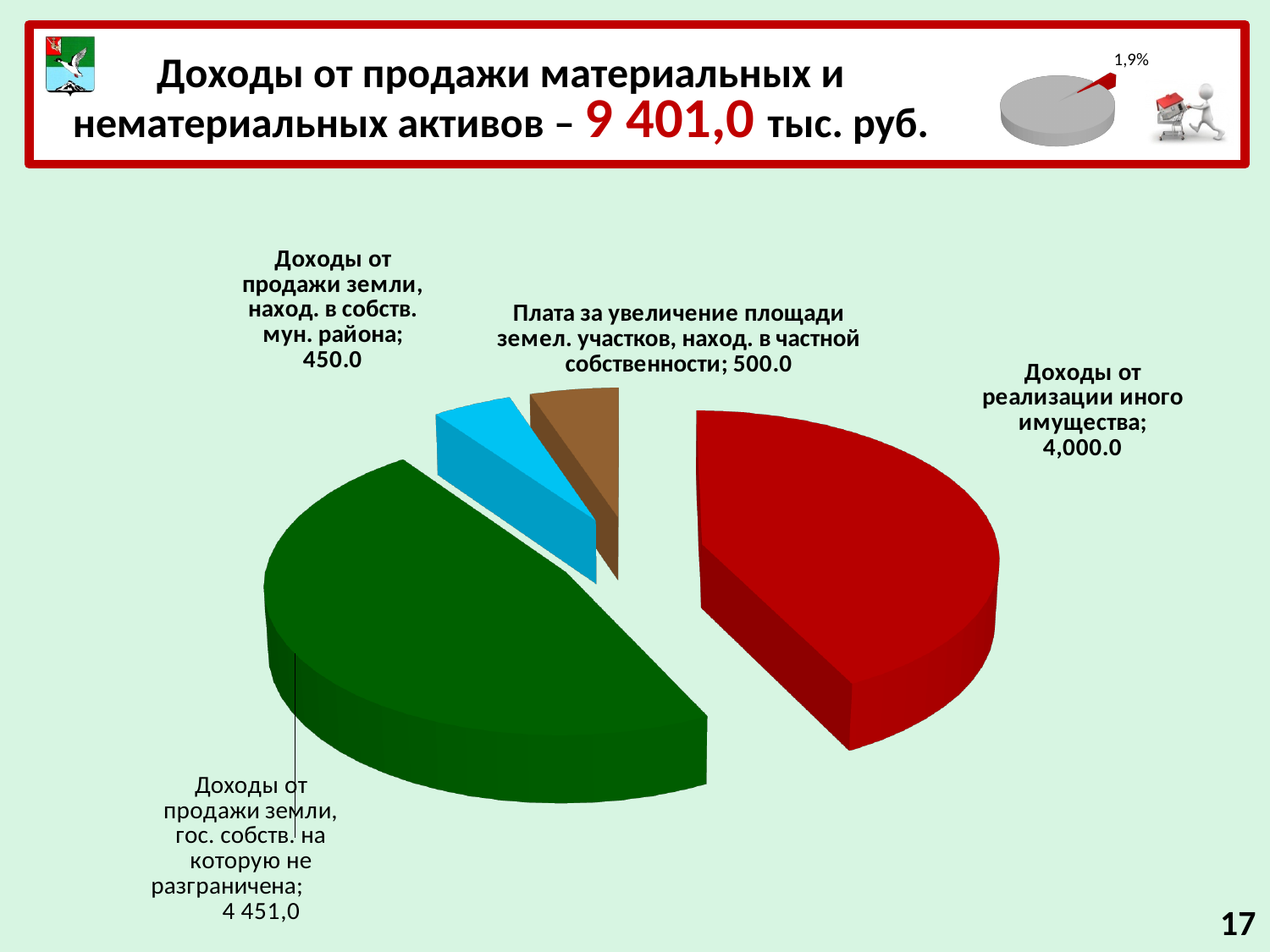
What is the value for "Доходы от продажи земли, гос. собств. на которую не разграничена"? 4 451,0 Which category has the smallest slice of the pie? Доходы от продажи земли, наход. в собств. мун. района What total amount in thousand rubles is stated in the slide title for income from the sale of tangible and intangible assets? 9 401,0 What is the value for "Доходы от продажи земли, наход. в собств. мун. района"? 450.0 Which is larger: "Доходы от реализации иного имущества" or "Плата за увеличение площади земел. участков, наход. в частной собственности"? Доходы от реализации иного имущества What is the value for "Доходы от реализации иного имущества"? 4,000.0 What colour is the slice for "Доходы от реализации иного имущества"? red What kind of chart is shown on the slide? pie chart Which category has the largest slice of the pie? Доходы от продажи земли, гос. собств. на которую не разграничена What is the value for "Плата за увеличение площади земел. участков, наход. в частной собственности"? 500.0 How many slices does the pie chart have? 4 What is the difference between "Плата за увеличение площади земел. участков, наход. в частной собственности" (500.0) and "Доходы от продажи земли, наход. в собств. мун. района" (450.0)? 50.0